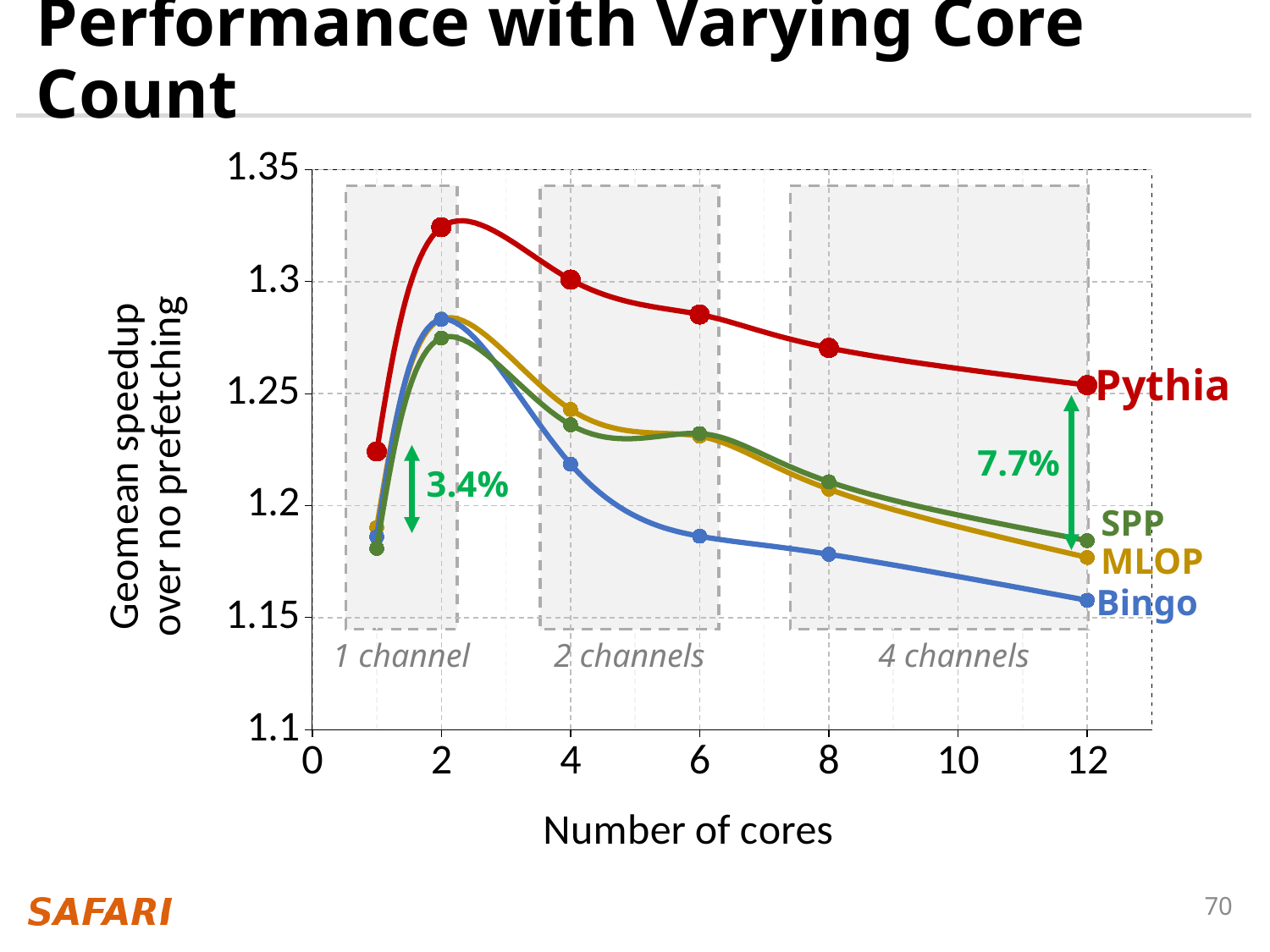
What kind of chart is shown on the slide? line chart Which series has the highest geomean speedup at 12 cores? Pythia Is the value for Pythia at 2 cores greater or less than 1.3? greater Which series has the lowest geomean speedup at 12 cores? Bingo What percentage improvement is annotated between Pythia and the next-best prefetcher at 12 cores? 7.7% At 4 cores, which has the larger geomean speedup, Pythia or Bingo? Pythia Which series has the highest geomean speedup at 2 cores? Pythia Does the Pythia line rise or fall as the number of cores increases from 2 to 12? fall How many series (prefetchers) are plotted in the chart? 4 Is the value for Bingo at 12 cores greater or less than 1.2? less How many core-count data points are plotted for each series? 6 Is the value for Pythia at 8 cores greater or less than 1.25? greater